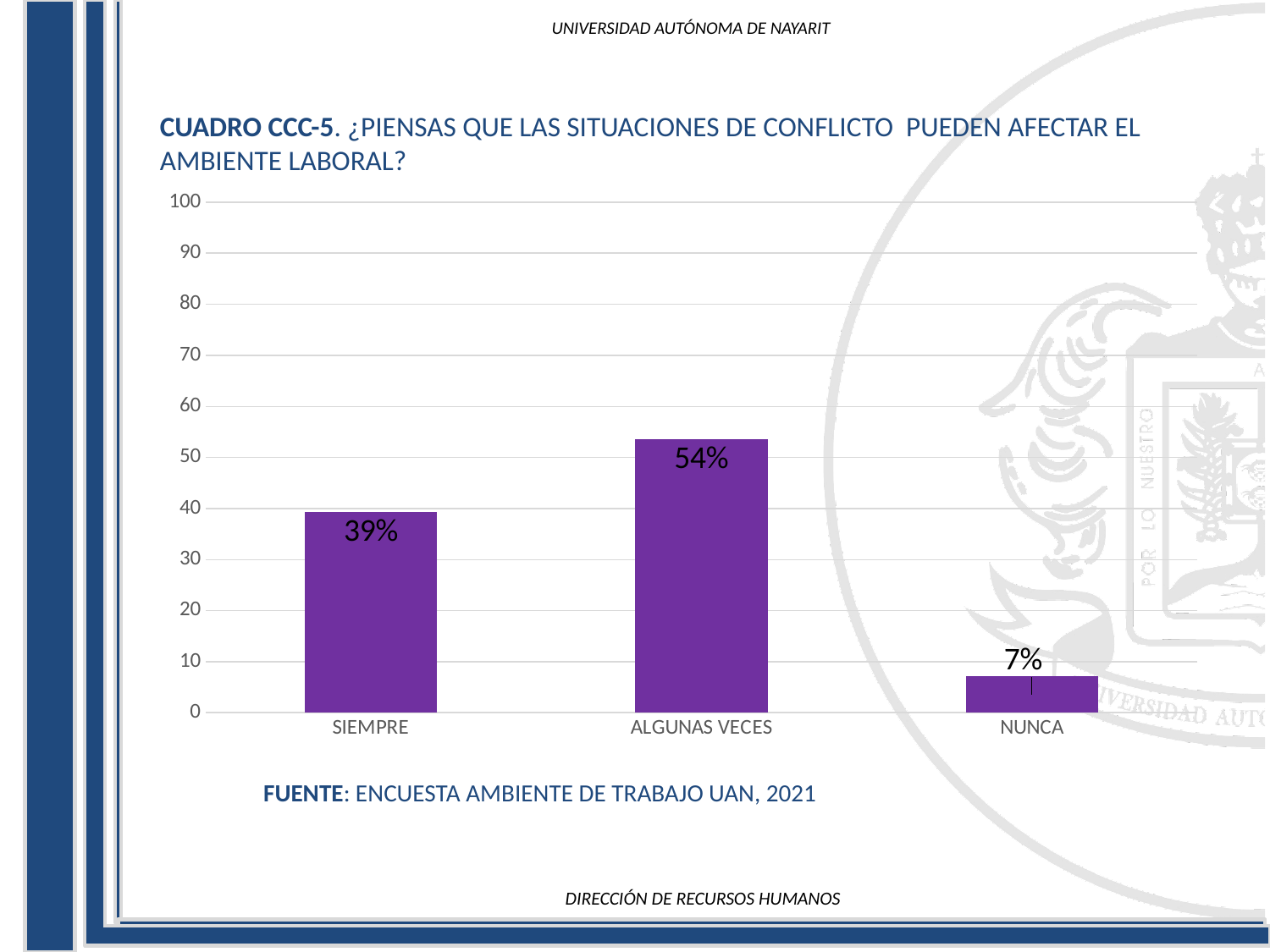
How many categories are shown on the x axis? 3 What is the value for SIEMPRE? 39% What source is cited below the chart? ENCUESTA AMBIENTE DE TRABAJO UAN, 2021 Which category has the lowest value? NUNCA What is the value for ALGUNAS VECES? 54% What is the difference between the values for SIEMPRE and NUNCA? 32% Which is larger, the value for SIEMPRE or the value for NUNCA? SIEMPRE What kind of chart is shown on the slide? bar chart What is the value for NUNCA? 7% What is the difference between the values for ALGUNAS VECES and SIEMPRE? 15% Is the value for ALGUNAS VECES greater or less than 50? greater Which category has the highest value? ALGUNAS VECES